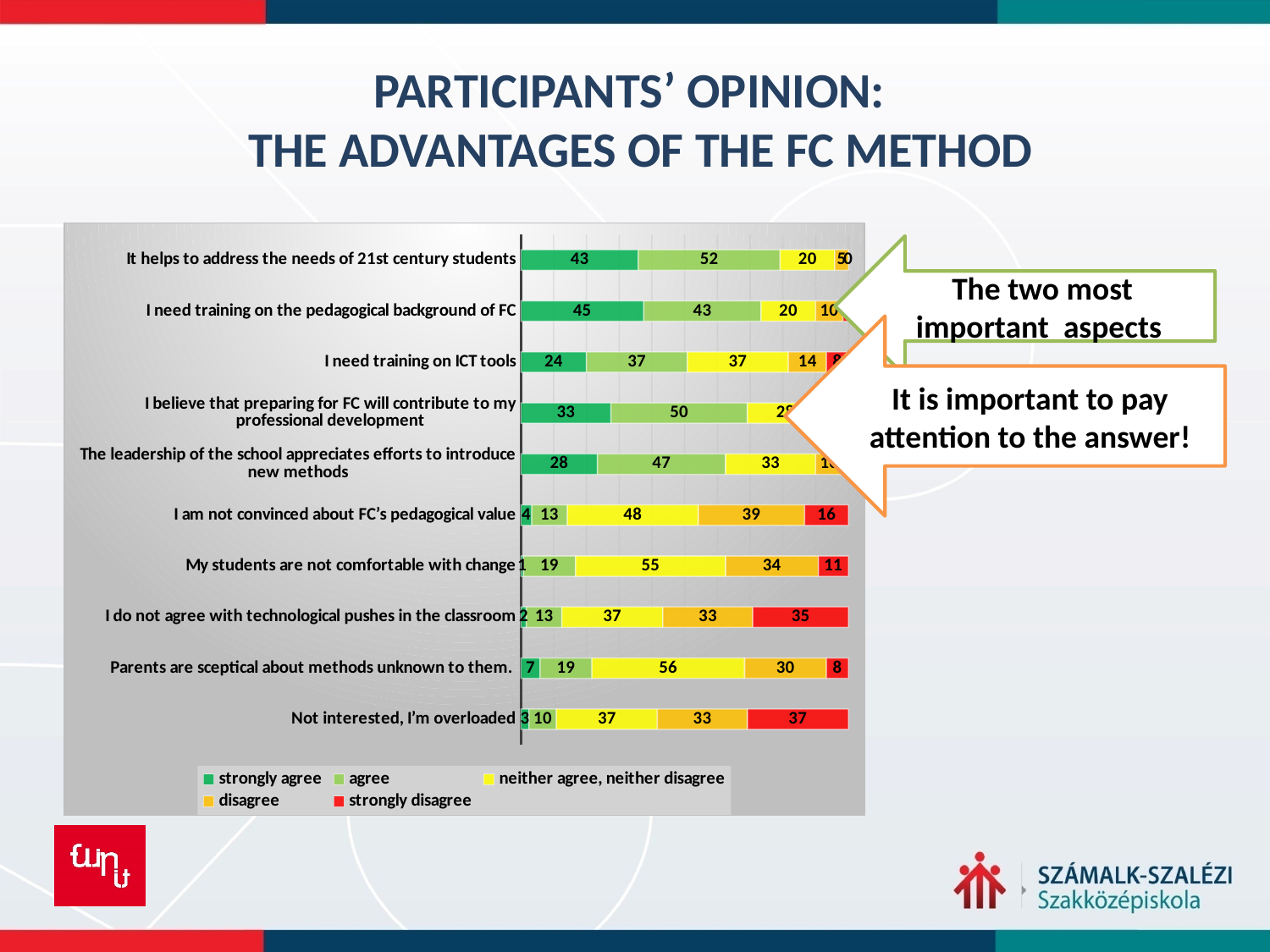
Which statement has the highest 'strongly agree' value? I need training on the pedagogical background of FC What is the 'strongly disagree' value for 'Not interested, I'm overloaded'? 37 What is the 'neither agree, neither disagree' value for 'Parents are sceptical about methods unknown to them.'? 56 Which statement has the highest 'strongly disagree' value? Not interested, I'm overloaded What is the 'strongly agree' value for 'I need training on the pedagogical background of FC'? 45 What is the total of all segments in the bar for 'My students are not comfortable with change'? 120 For 'I am not convinced about FC's pedagogical value', what is the difference between the 'disagree' and 'strongly disagree' values? 23 What is the 'agree' value for 'It helps to address the needs of 21st century students'? 52 What kind of chart is shown on the slide? bar chart Which has the larger 'agree' value: 'I need training on ICT tools' or 'I believe that preparing for FC will contribute to my professional development'? I believe that preparing for FC will contribute to my professional development How many statements (categories) are plotted in the chart? 10 How many series does the legend list? 5